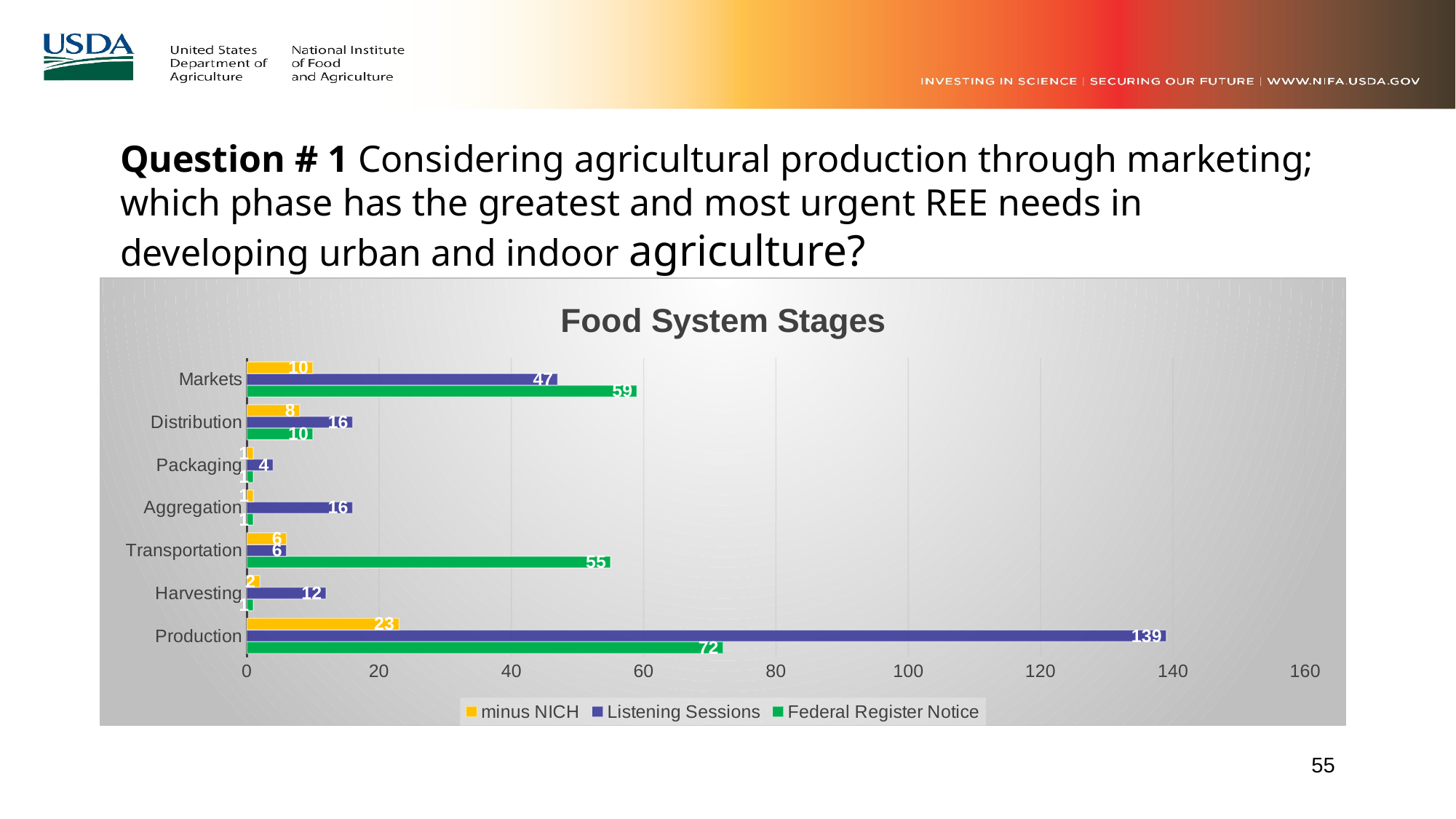
What is the minus NICH value for Markets? 10 How many series does the legend list? 3 What kind of chart is shown? bar chart Which is larger for Markets: the Listening Sessions value or the Federal Register Notice value? Federal Register Notice Which category has the lowest Listening Sessions value? Packaging What is the difference between the Listening Sessions and Federal Register Notice values for Production? 67 Is the Listening Sessions value for Production greater or less than 120? greater Which category has the highest Federal Register Notice value? Production What is the title of the chart? Food System Stages What is the Federal Register Notice value for Transportation? 55 How many categories are shown on the y axis? 7 What is the Listening Sessions value for Production? 139